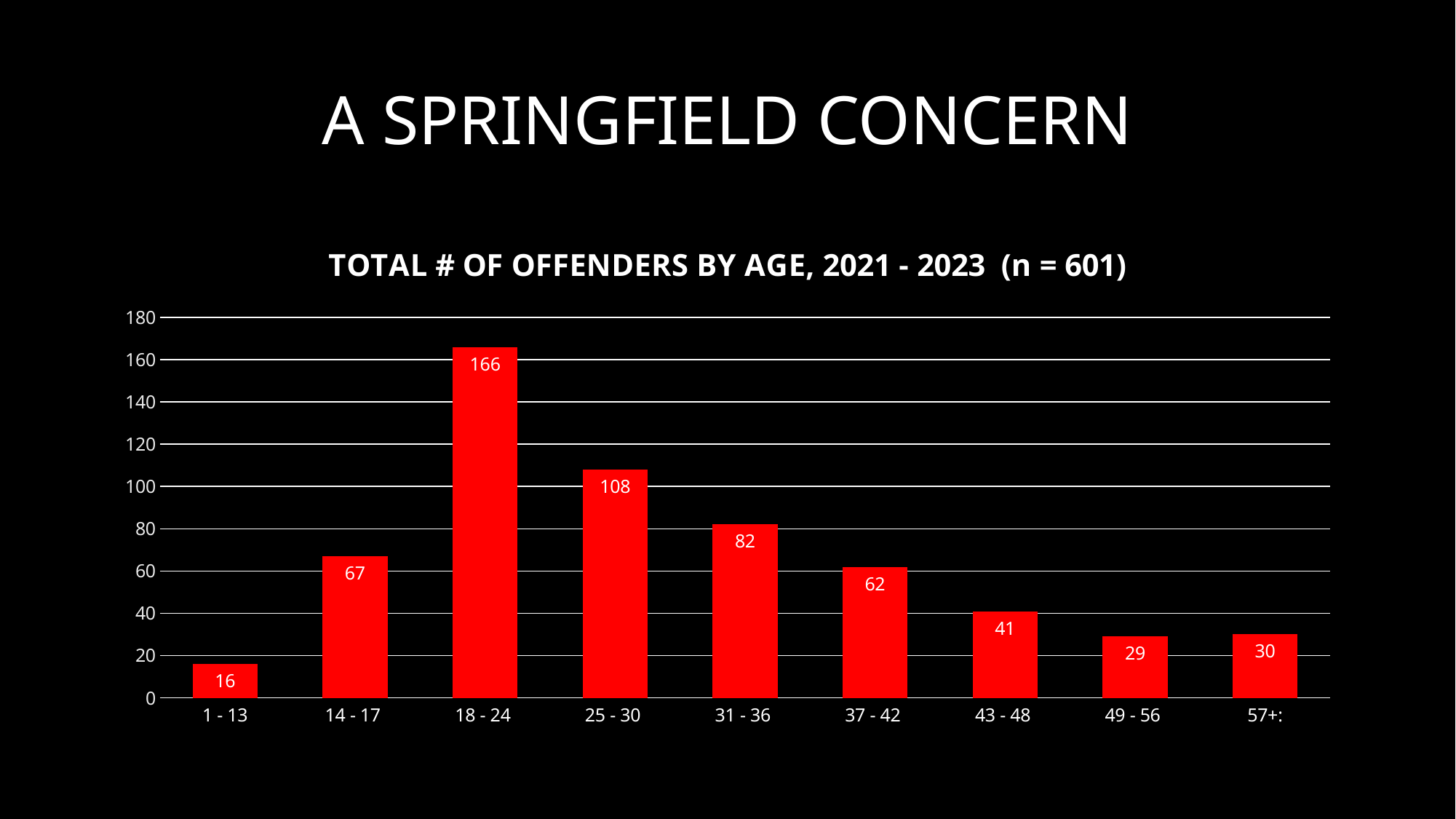
What kind of chart is shown on the slide? bar chart What colour are the bars in the chart? red Do the values rise or fall from the 18 - 24 group to the 49 - 56 group? fall Which age group has the highest number of offenders? 18 - 24 Which age group has the lowest number of offenders? 1 - 13 Which is larger, the value for 14 - 17 or the value for 37 - 42? 14 - 17 What is the difference between the values for 18 - 24 and 25 - 30? 58 What is the value for the 18 - 24 age group? 166 What is the value for the 49 - 56 age group? 29 What is the title of the chart? TOTAL # OF OFFENDERS BY AGE, 2021 - 2023 (n = 601) Is the value for 31 - 36 greater or less than 100? less How many age groups are shown on the x axis? 9